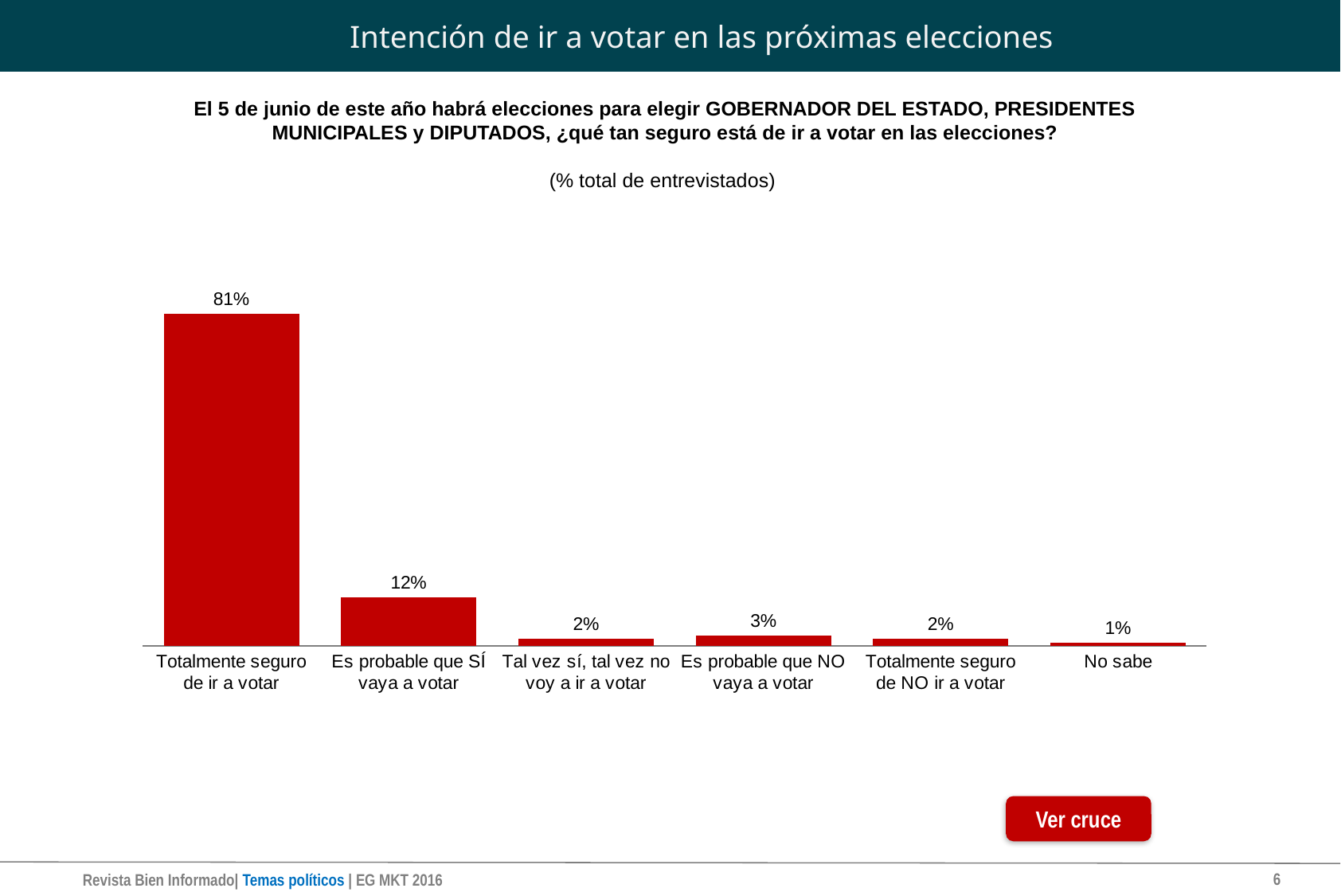
Which category has the lowest value? No sabe What is the difference between "Totalmente seguro de ir a votar" and "Es probable que SÍ vaya a votar"? 69% What is the value for "Es probable que NO vaya a votar"? 3% Which category has the highest value? Totalmente seguro de ir a votar What colour are the bars in the chart? Red What is the difference between "Es probable que NO vaya a votar" and "No sabe"? 2% What is the value for "Totalmente seguro de ir a votar"? 81% What is the value for "No sabe"? 1% How many categories are shown in the chart? 6 What is the value for "Es probable que SÍ vaya a votar"? 12% Which is larger, "Es probable que SÍ vaya a votar" or "Es probable que NO vaya a votar"? Es probable que SÍ vaya a votar What kind of chart is shown on the slide? Bar chart